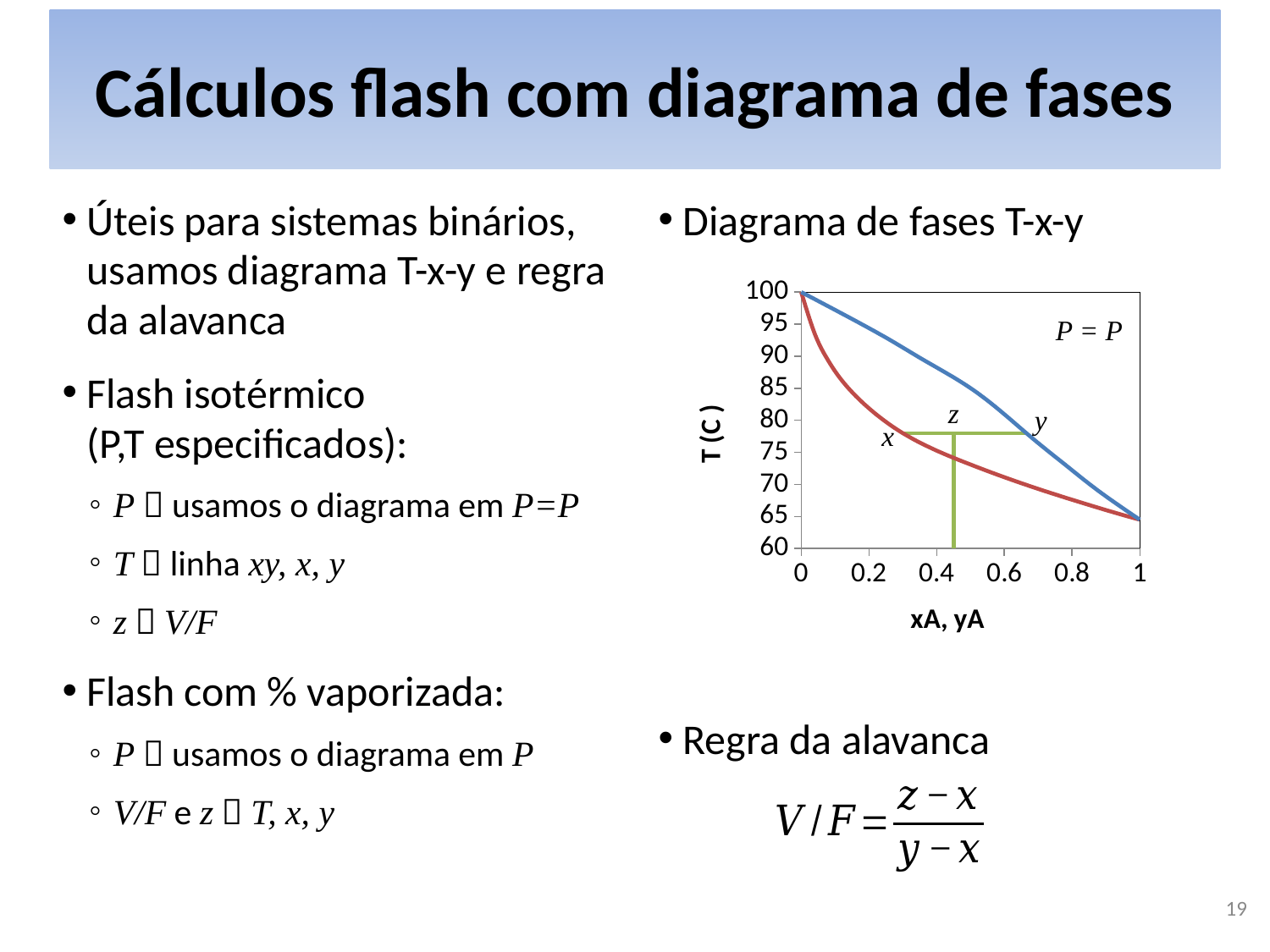
What is the title of the horizontal axis of the chart? xA, yA Is the value of the red curve at xA, yA = 0.2 greater or less than 85? less Is the value of the blue curve at xA, yA = 0.2 greater or less than 90? greater Do the curves on the chart rise or fall as xA, yA increases from 0 to 1? fall At xA, yA = 0.4, which curve has the higher temperature, the blue one or the red one? the blue one What is the temperature at which both curves start at xA, yA = 0? 100 What is the highest value shown on the vertical axis of the chart? 100 Is the value of the red curve at xA, yA = 0.8 greater or less than 75? less What kind of chart is shown on the slide? line chart What is the title of the vertical axis of the chart? T (C) How many curves are plotted on the chart? 2